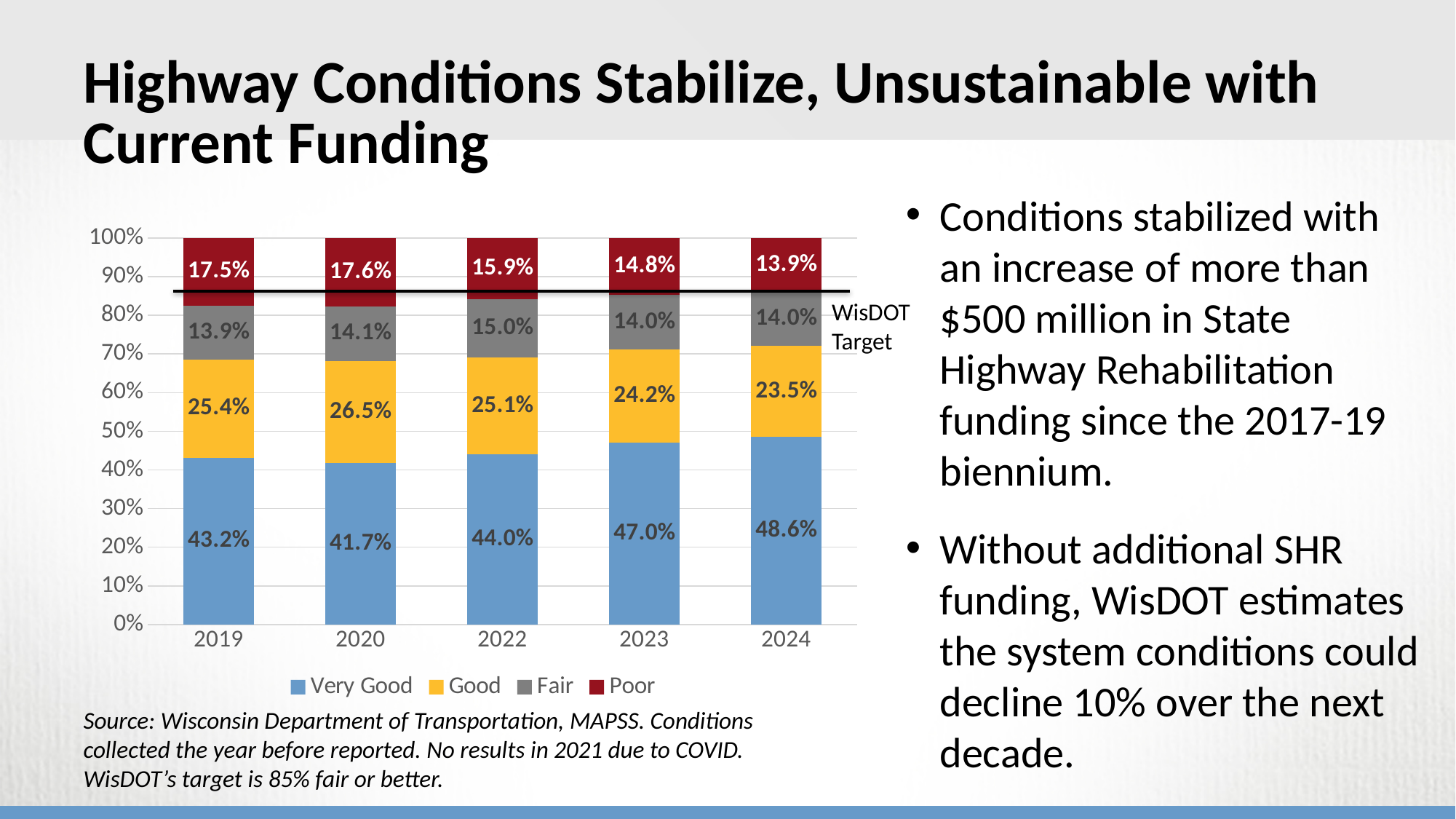
In which year is the Very Good share the highest? 2024 In which year is the Poor share the lowest? 2024 What is the Good value for 2020? 26.5% What kind of chart is shown on the slide? Stacked bar chart How many years are shown on the x axis of the chart? 5 By how many percentage points did the Very Good share increase from 2019 to 2024? 5.4 percentage points What is the Poor share shown for 2019? 17.5% What does the horizontal black line across the chart represent? WisDOT Target How many series does the chart legend list? 4 Which year has the larger Good share, 2020 or 2024? 2020 What is the Fair value for 2022? 15.0% What percentage of highways were rated Very Good in 2024? 48.6%